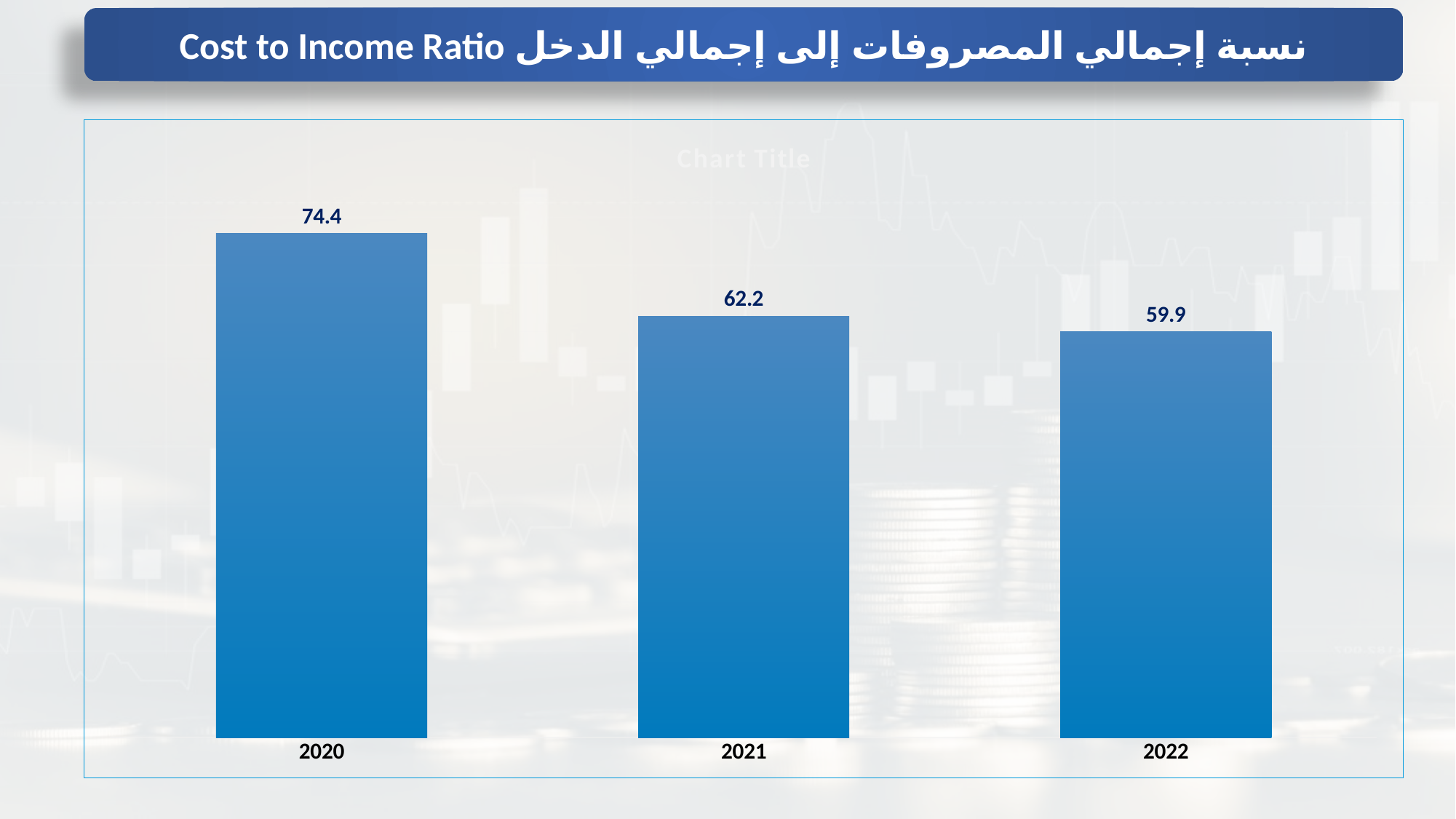
Do the values rise or fall from 2020 to 2022? Fall What is the cost to income ratio for 2020? 74.4 How many years are shown on the chart? 3 Which is larger, the value for 2020 or the value for 2022? 2020 What is the difference between the 2020 and 2021 values? 12.2 What is the cost to income ratio for 2022? 59.9 What is the cost to income ratio for 2021? 62.2 Which year has the lowest cost to income ratio? 2022 What kind of chart is shown on the slide? Bar chart What is the difference between the 2021 and 2022 values? 2.3 What is the English title shown in the header of the slide? Cost to Income Ratio Which year has the highest cost to income ratio? 2020